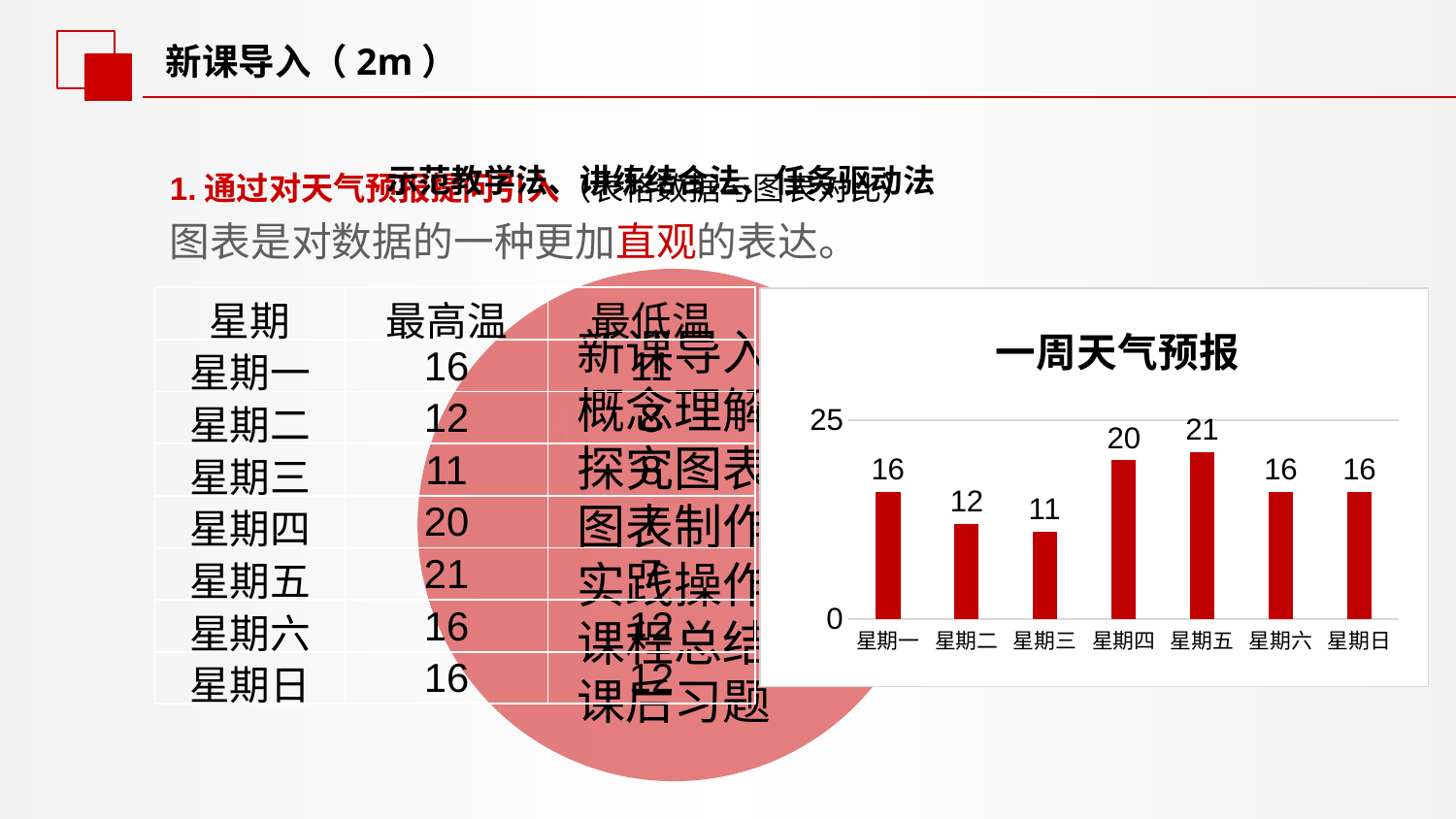
Is the value for 星期五 greater or less than 25? less What type of chart is shown on the slide? bar chart What is the title of the chart? 一周天气预报 Which category has the highest value in the chart? 星期五 How many categories are shown on the x axis of the chart? 7 What is the difference between the values for 星期四 and 星期二? 8 What is the value for 星期三 in the chart? 11 What is the difference between the values for 星期五 and 星期三? 10 What is the value for 星期五 in the chart? 21 Which is larger, the value for 星期四 or the value for 星期六? 星期四 What is the value for 星期一 in the chart? 16 Which category has the lowest value in the chart? 星期三